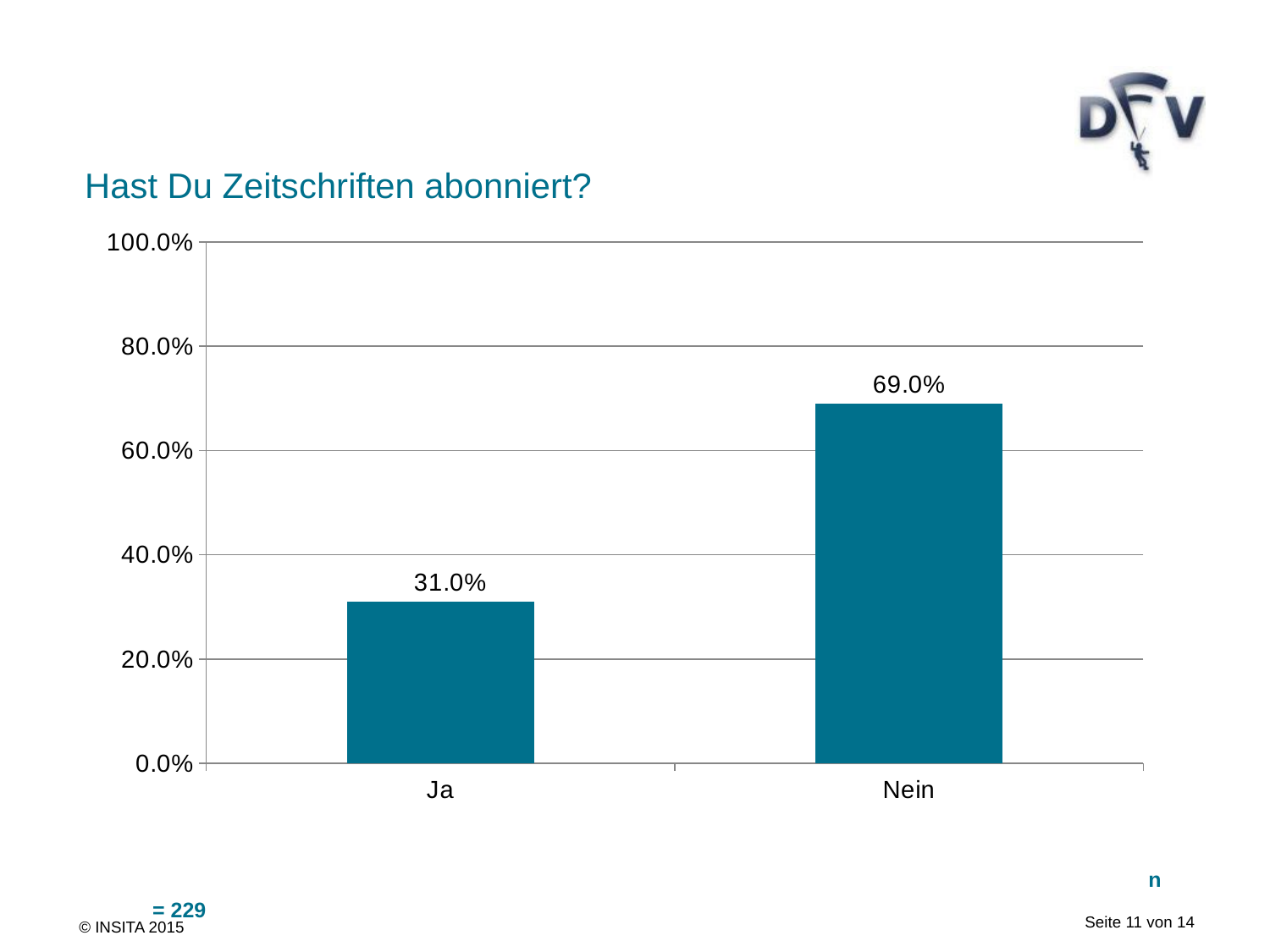
Is the value for "Nein" greater or less than 60.0%? greater Which category has the highest value? Nein Is the value for "Ja" greater or less than 40.0%? less What is the value for "Nein"? 69.0% What is the highest value shown on the y axis? 100.0% What kind of chart is shown on the slide? bar chart Which is larger, the value for "Ja" or the value for "Nein"? Nein What is the difference between the values for "Nein" and "Ja"? 38.0% What is the title of the chart? Hast Du Zeitschriften abonniert? Which category has the lowest value? Ja How many categories are shown on the x axis? 2 What is the value for "Ja"? 31.0%